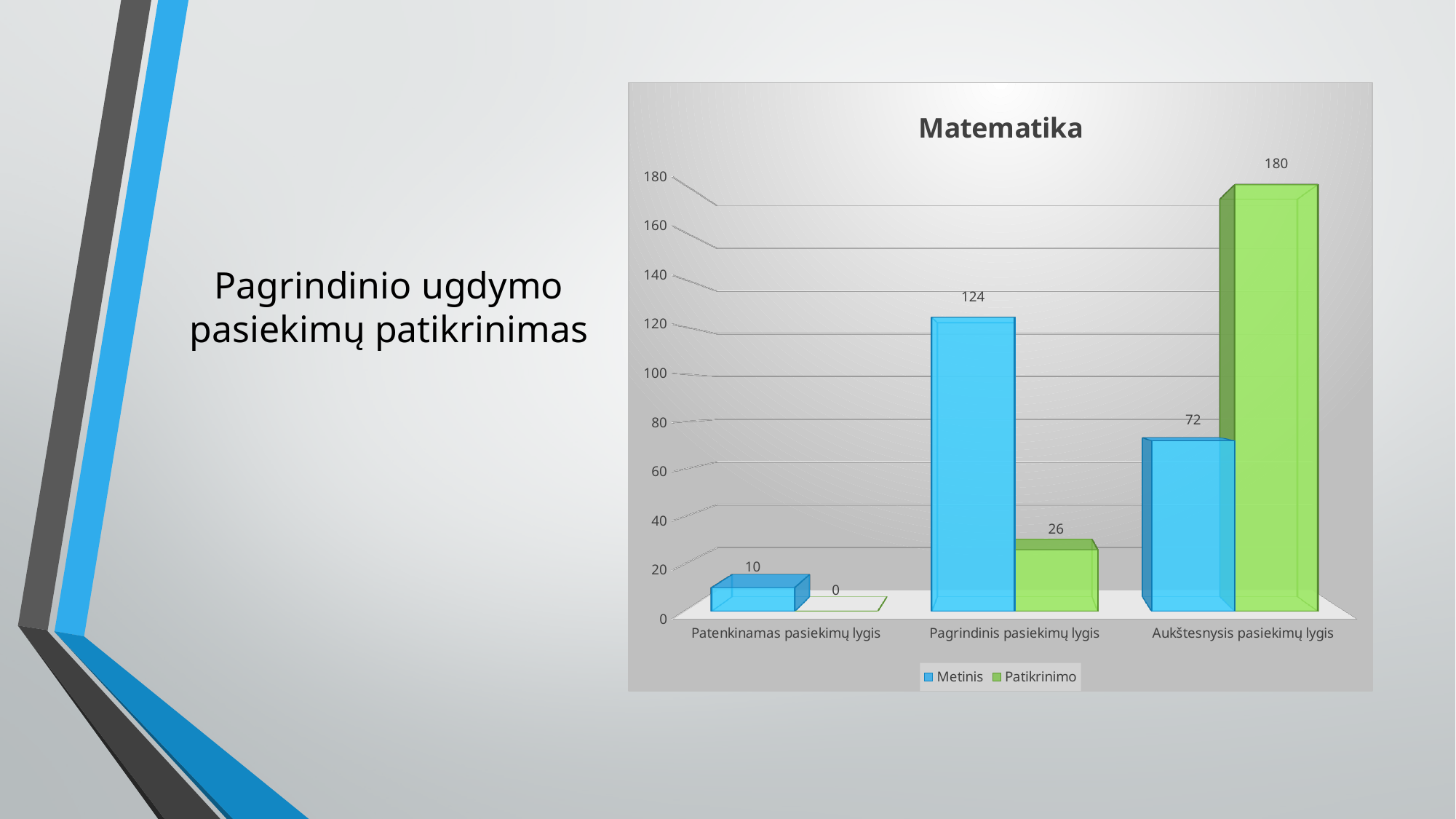
Which category has the lowest Patikrinimo value? Patenkinamas pasiekimų lygis How many series does the legend list? 2 Which is larger for Pagrindinis pasiekimų lygis: the Metinis value or the Patikrinimo value? Metinis What is the difference between the Patikrinimo and Metinis values for Aukštesnysis pasiekimų lygis? 108 How many categories are shown on the x axis? 3 What is the Metinis value for Aukštesnysis pasiekimų lygis? 72 What is the Metinis value for Pagrindinis pasiekimų lygis? 124 Which category has the highest Metinis value? Pagrindinis pasiekimų lygis What is the Patikrinimo value for Patenkinamas pasiekimų lygis? 0 What is the title of the chart? Matematika What kind of chart is shown on the slide? Bar chart What is the Patikrinimo value for Aukštesnysis pasiekimų lygis? 180